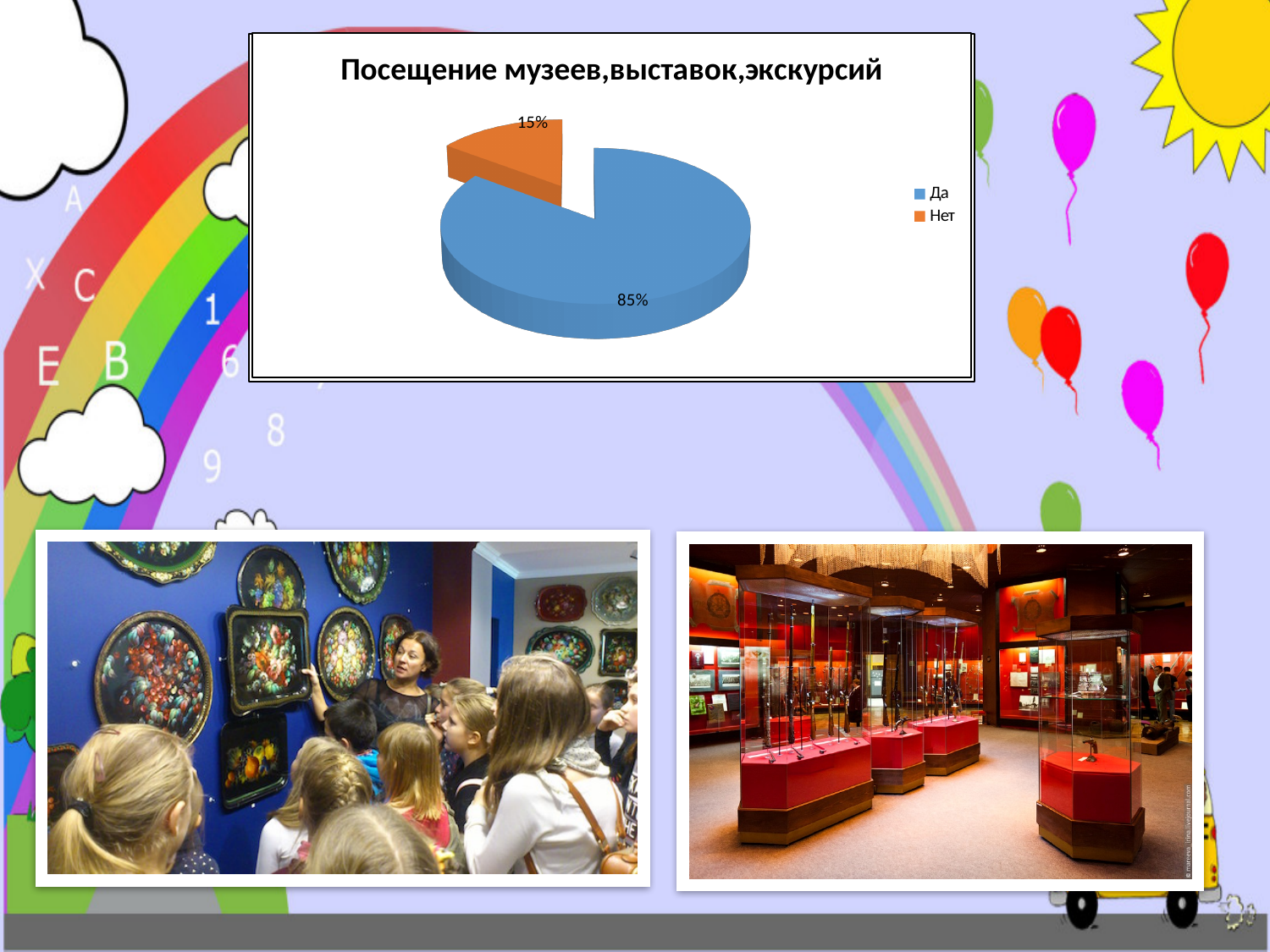
Which is larger, the "Да" slice or the "Нет" slice? Да Which slice is the smallest? Нет What is the difference between the "Да" and "Нет" shares? 70% Which slice is the largest? Да What kind of chart is shown on the slide? pie chart What is the title of the chart? Посещение музеев,выставок,экскурсий How many entries does the legend list? 2 What percentage is shown for the "Нет" slice? 15% What colour is the "Нет" slice? orange How many slices does the pie chart have? 2 What percentage is shown for the "Да" slice? 85% What share of the pie does the "Да" slice represent? 85%